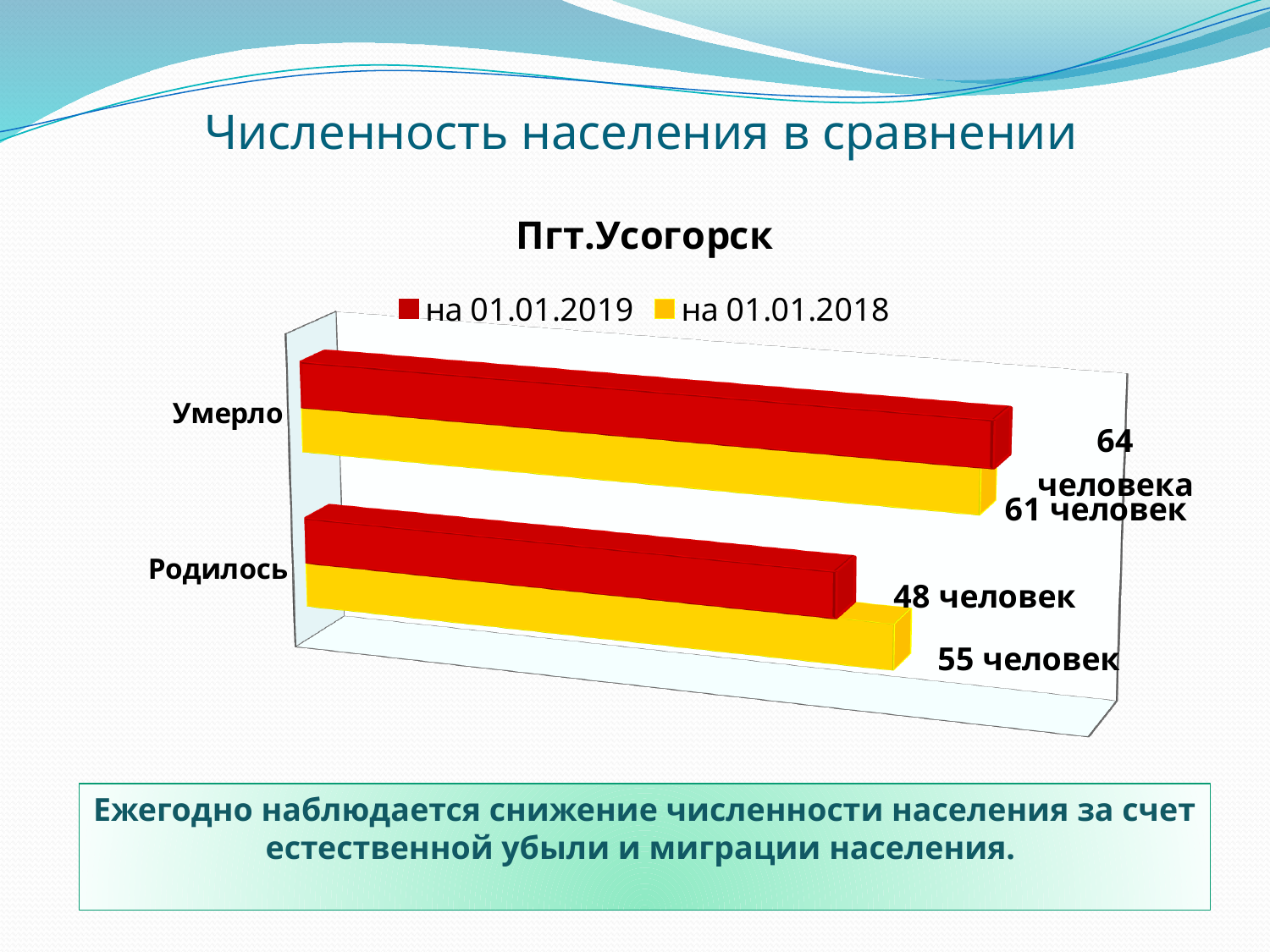
What is the value for Умерло in the series на 01.01.2018? 61 человек What is the difference between the Родилось values for на 01.01.2018 and на 01.01.2019? 7 Which category has the lower value in the series на 01.01.2018? Родилось What is the value for Родилось in the series на 01.01.2019? 48 человек What is the value for Умерло in the series на 01.01.2019? 64 человека What type of chart is shown on the slide? Bar chart For Родилось, which series has the larger value: на 01.01.2019 or на 01.01.2018? на 01.01.2018 How many series does the legend list? 2 How many categories are shown on the chart? 2 What is the value for Родилось in the series на 01.01.2018? 55 человек What is the difference between the Умерло values for на 01.01.2019 and на 01.01.2018? 3 Which category has the higher value in the series на 01.01.2019? Умерло